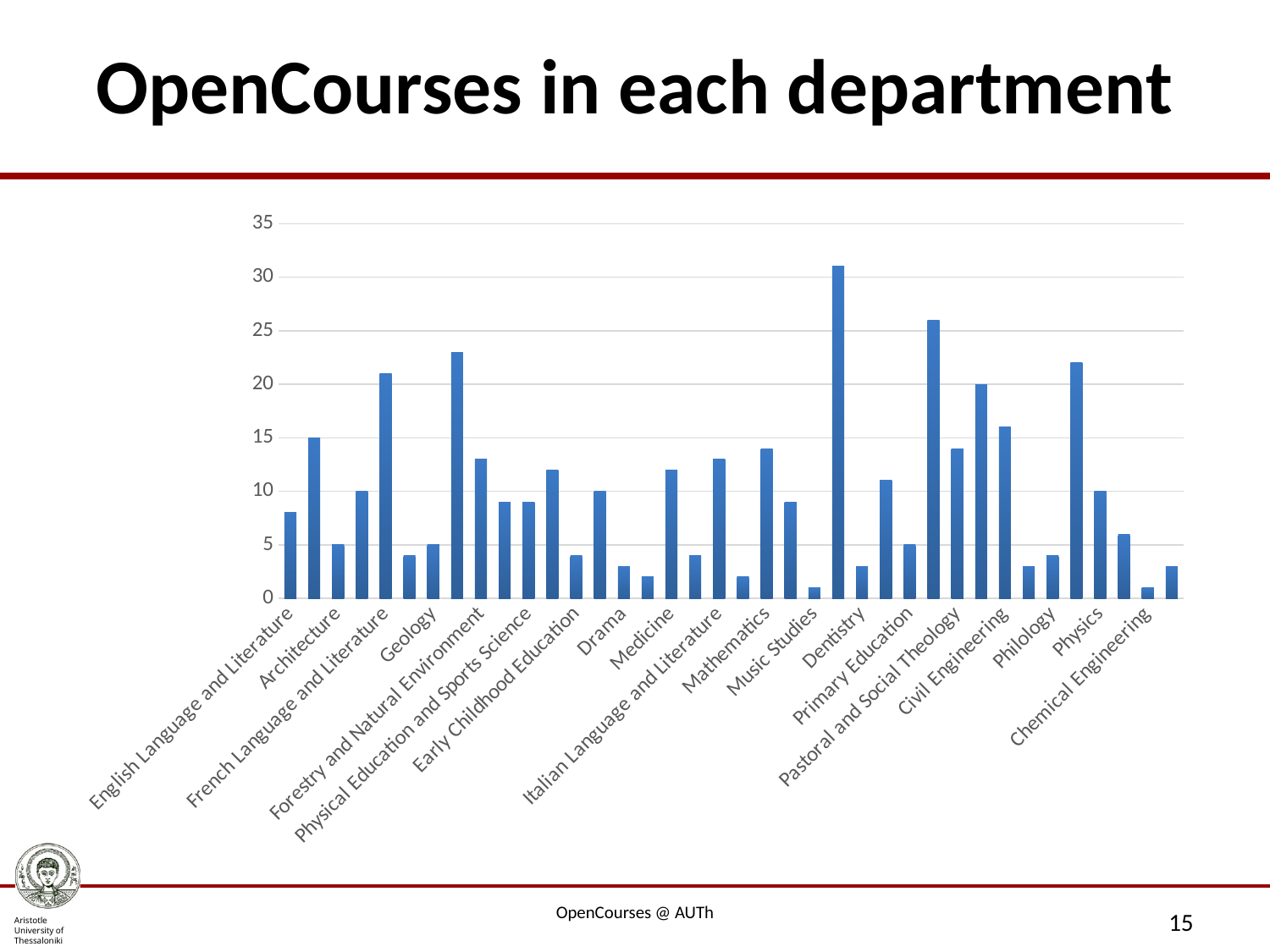
Is the value for Philology greater or less than 5? less Is the value for English Language and Literature greater or less than 10? less Is the value for Geology greater or less than 10? less What is the highest value shown on the vertical axis of the chart? 35 What kind of chart is shown on the slide? bar chart What is the title of the slide containing the chart? OpenCourses in each department